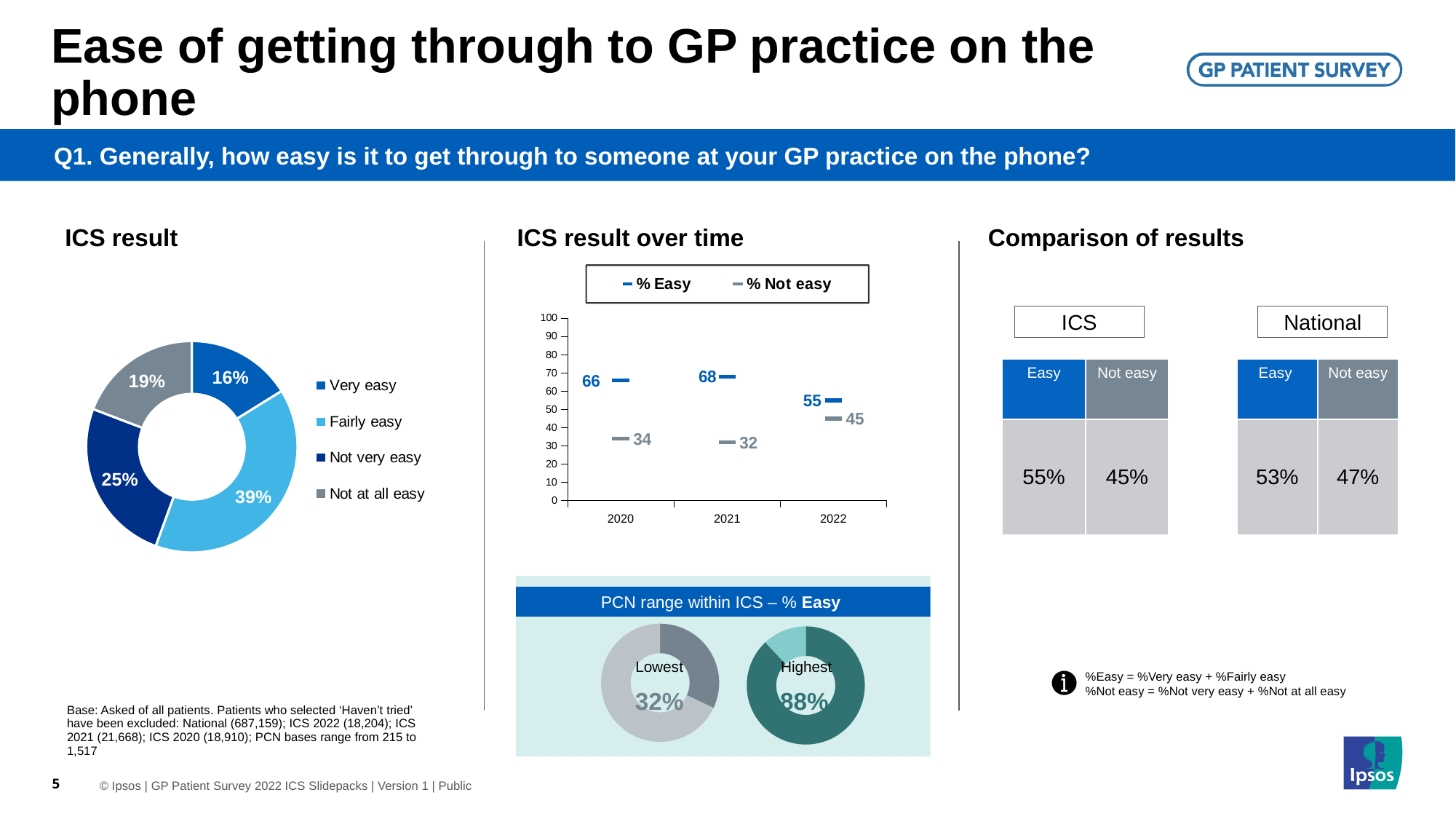
In the 'ICS result over time' chart, which year has the lowest '% Easy' value? 2022 In the 'ICS result' donut chart, how many categories does the legend list? 4 In the 'ICS result' donut chart, which category has the smallest share? Very easy In the 'PCN range within ICS – % Easy' section, what is the 'Highest' value? 88% In the 'ICS result over time' chart, how many series does the legend list? 2 In the 'ICS result over time' chart, what is the difference between the '% Easy' values for 2021 and 2022? 13 In the 'ICS result over time' chart, is the '% Easy' value for 2020 larger or smaller than the '% Not easy' value for 2020? larger In the 'ICS result' donut chart, what is the difference between the 'Not very easy' and 'Not at all easy' shares? 6% In the 'ICS result over time' chart, what is the '% Not easy' value for 2022? 45 In the 'ICS result' donut chart, what percentage of patients said 'Fairly easy'? 39% In the 'ICS result over time' chart, what is the '% Easy' value for 2021? 68 In the 'ICS result' donut chart, which category has the largest share? Fairly easy